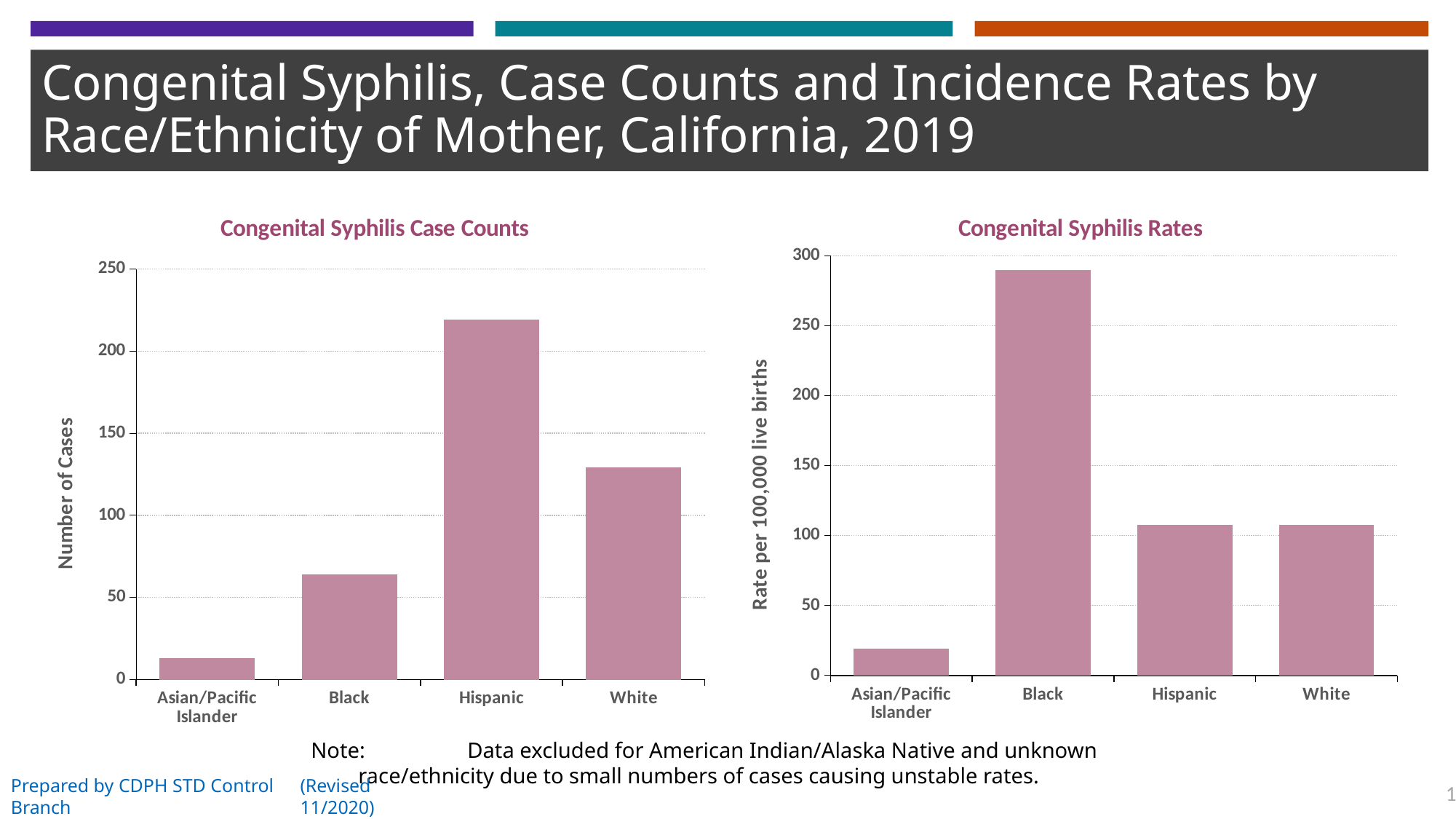
In the Congenital Syphilis Case Counts chart, is the value for Black greater or less than 100? less In the Congenital Syphilis Rates chart, is the value for Black greater or less than 250? greater In the Congenital Syphilis Case Counts chart, is the value for Hispanic greater or less than 200? greater What type of chart is the Congenital Syphilis Case Counts chart? Bar chart In the Congenital Syphilis Rates chart, which race/ethnicity has the highest rate per 100,000 live births? Black In the Congenital Syphilis Rates chart, which race/ethnicity has the lowest rate per 100,000 live births? Asian/Pacific Islander In the Congenital Syphilis Case Counts chart, which race/ethnicity has the highest number of cases? Hispanic In the Congenital Syphilis Rates chart, which has a higher rate, Black or Hispanic? Black In the Congenital Syphilis Case Counts chart, which has more cases, White or Black? White In the Congenital Syphilis Case Counts chart, which race/ethnicity has the lowest number of cases? Asian/Pacific Islander How many race/ethnicity categories are shown in the Congenital Syphilis Rates chart? 4